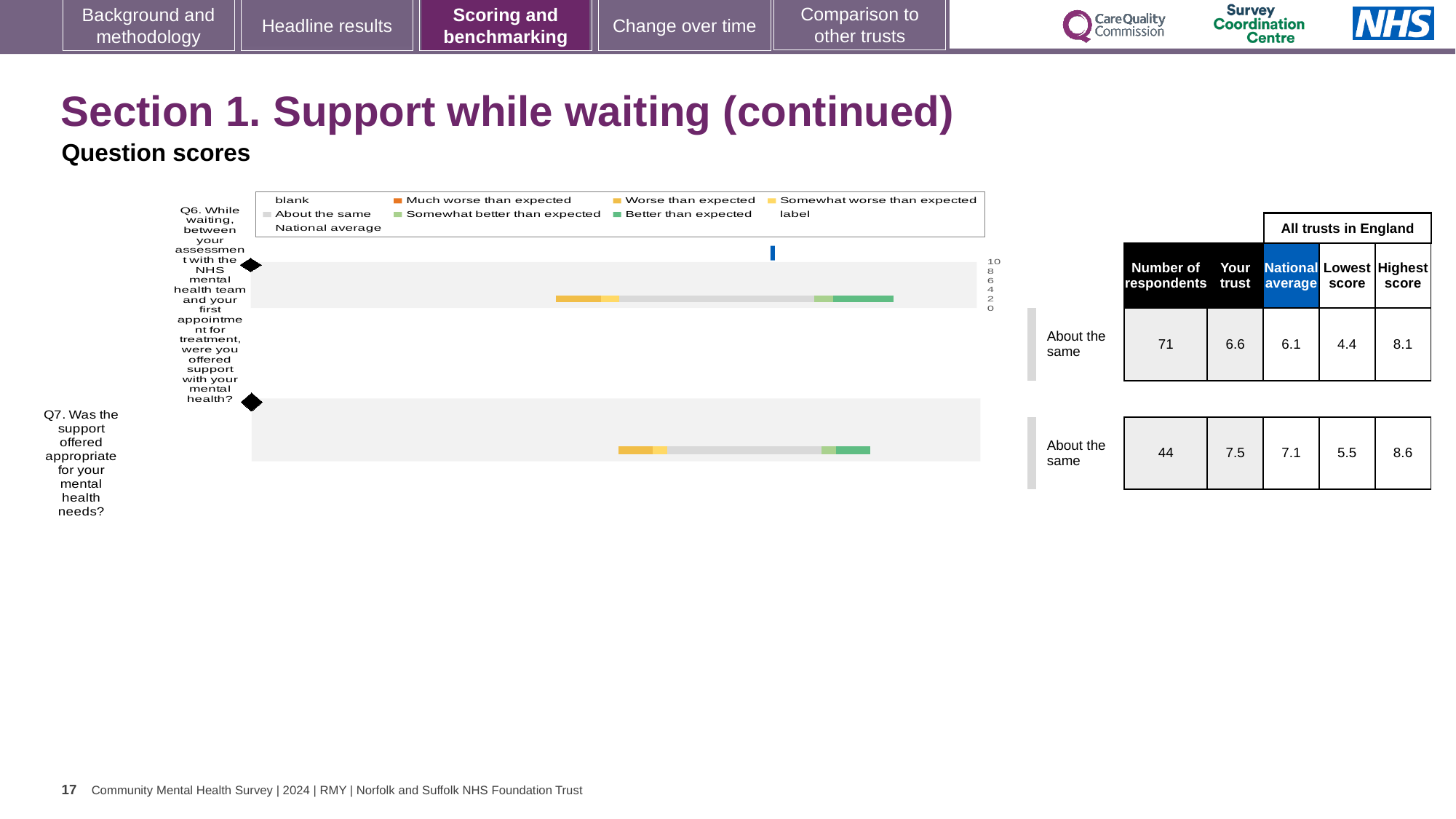
Which question has the higher 'Your trust' score, Q6 or Q7? Q7 Which benchmark category is Q6 assigned to on the slide? About the same How many respondents answered Q7? 44 What is the difference between the highest and lowest scores across all trusts in England for Q6? 3.7 What kind of chart is shown on the slide? bar chart In the table beside the chart, what is the 'Your trust' score for Q7? 7.5 In the table beside the chart, what is the 'Your trust' score for Q6? 6.6 What is the difference between the 'Your trust' score and the national average for Q7? 0.4 How many survey questions are plotted in the chart? 2 What is the national average score for Q6 shown in the table? 6.1 What is the national average score for Q7 shown in the table? 7.1 What is the highest score among all trusts in England for Q7? 8.6